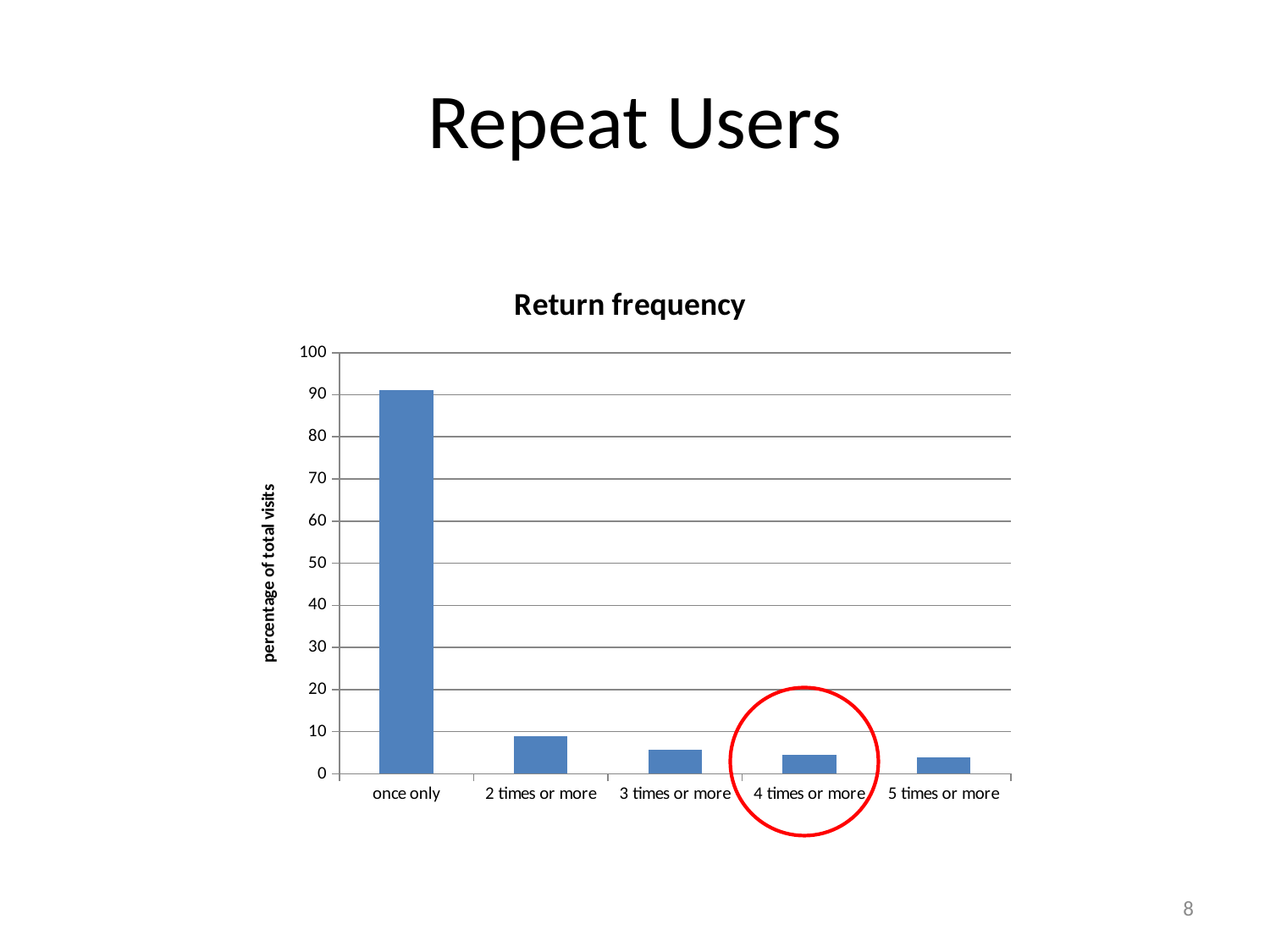
Which is larger, the value for once only or the value for 2 times or more? once only What is the title of the chart? Return frequency How many categories are shown on the x axis of the chart? 5 Which is larger, the value for 2 times or more or the value for 5 times or more? 2 times or more Is the value for 5 times or more greater or less than 10? less What kind of chart is shown on the slide? bar chart Do the values rise or fall moving from left to right along the x axis? fall Which category has the highest value in the chart? once only Is the value for 2 times or more greater or less than 20? less Is the value for once only greater or less than 80? greater What is the label on the vertical axis of the chart? percentage of total visits